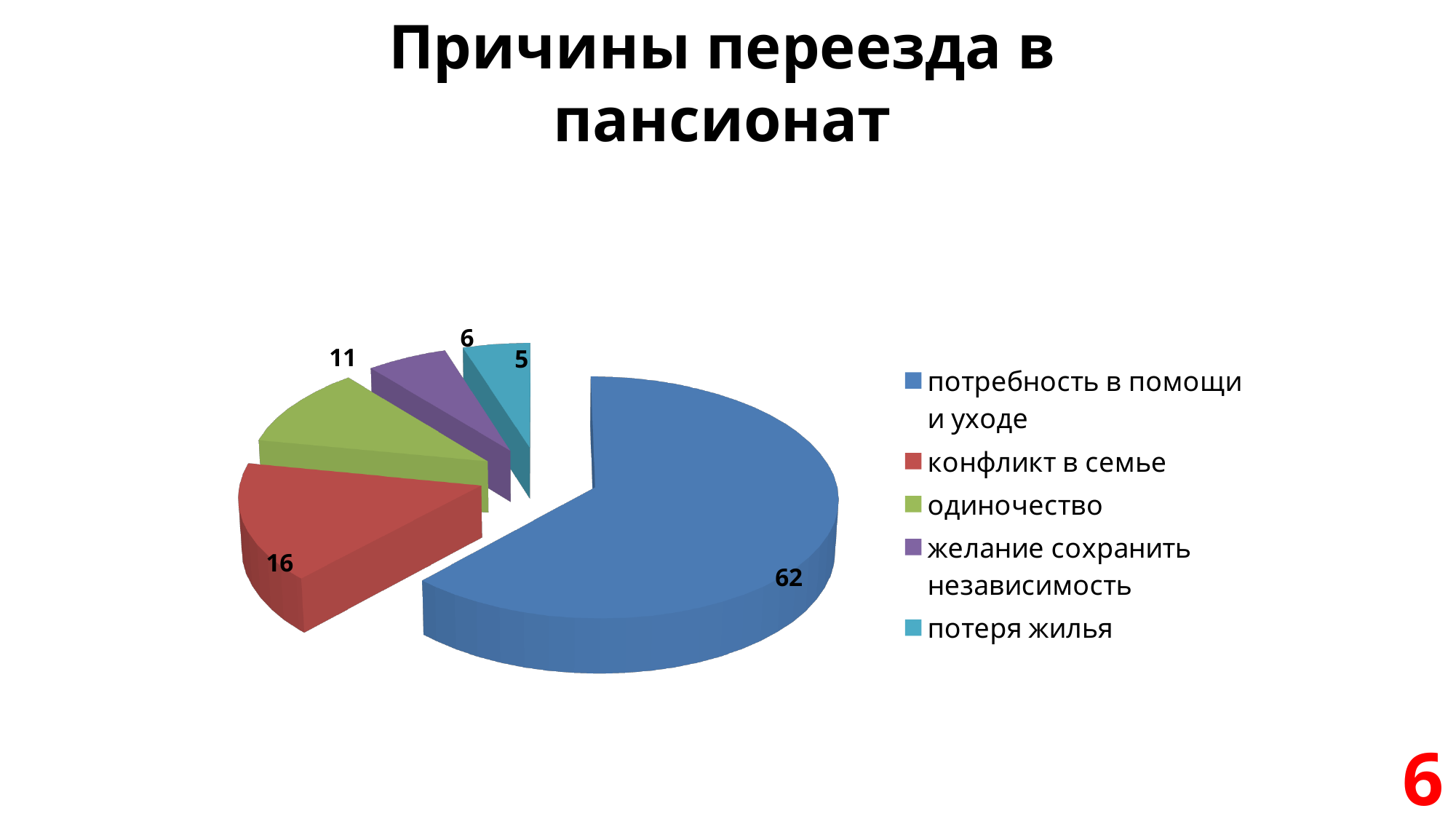
What is the difference between the values for "конфликт в семье" and "одиночество"? 5 What is the value for "потребность в помощи и уходе"? 62 What is the value for "одиночество"? 11 What is the title of the slide? Причины переезда в пансионат What is the value for "потеря жилья"? 5 Which category has the largest slice? потребность в помощи и уходе Which is larger, the value for "желание сохранить независимость" or the value for "потеря жилья"? желание сохранить независимость How many categories does the pie chart have? 5 Which category has the smallest slice? потеря жилья What kind of chart is shown on the slide? pie chart What is the value for "конфликт в семье"? 16 What share of the pie does "потребность в помощи и уходе" represent? 62%